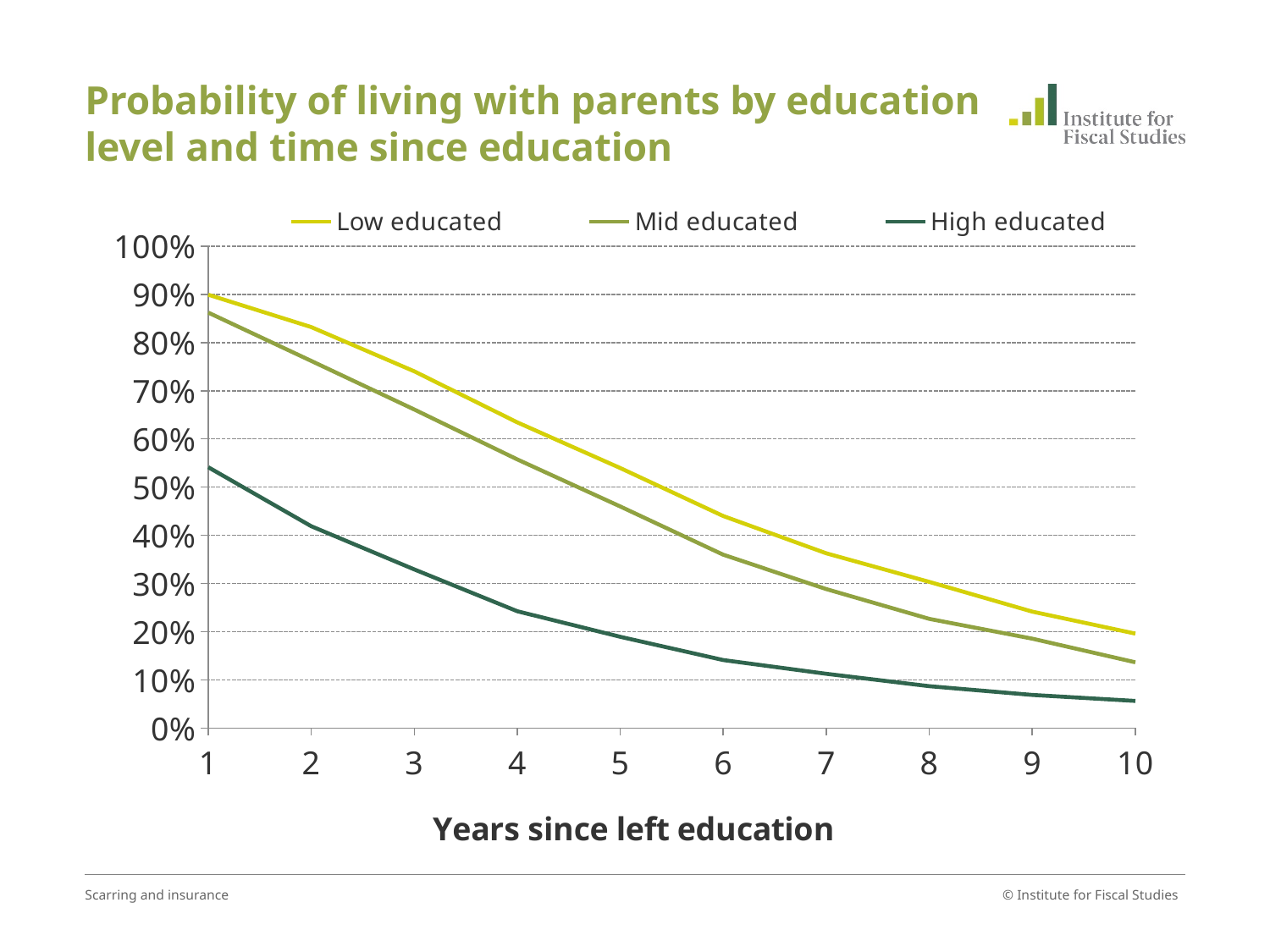
Is the value for Mid educated at year 6 greater or less than 40%? less Is the value for High educated at year 1 greater or less than 50%? greater What kind of chart is shown on the slide? line chart Do the values for the Low educated series rise or fall as years since leaving education increase? fall Is the value for Mid educated at year 1 greater or less than 80%? greater Which series has the highest probability of living with parents at year 1? Low educated How many series does the legend list? 3 At year 5, which series has the larger value: Low educated or High educated? Low educated What is the title of the x axis? Years since left education How many years are shown along the x axis? 10 Which series has the lowest probability of living with parents at year 10? High educated